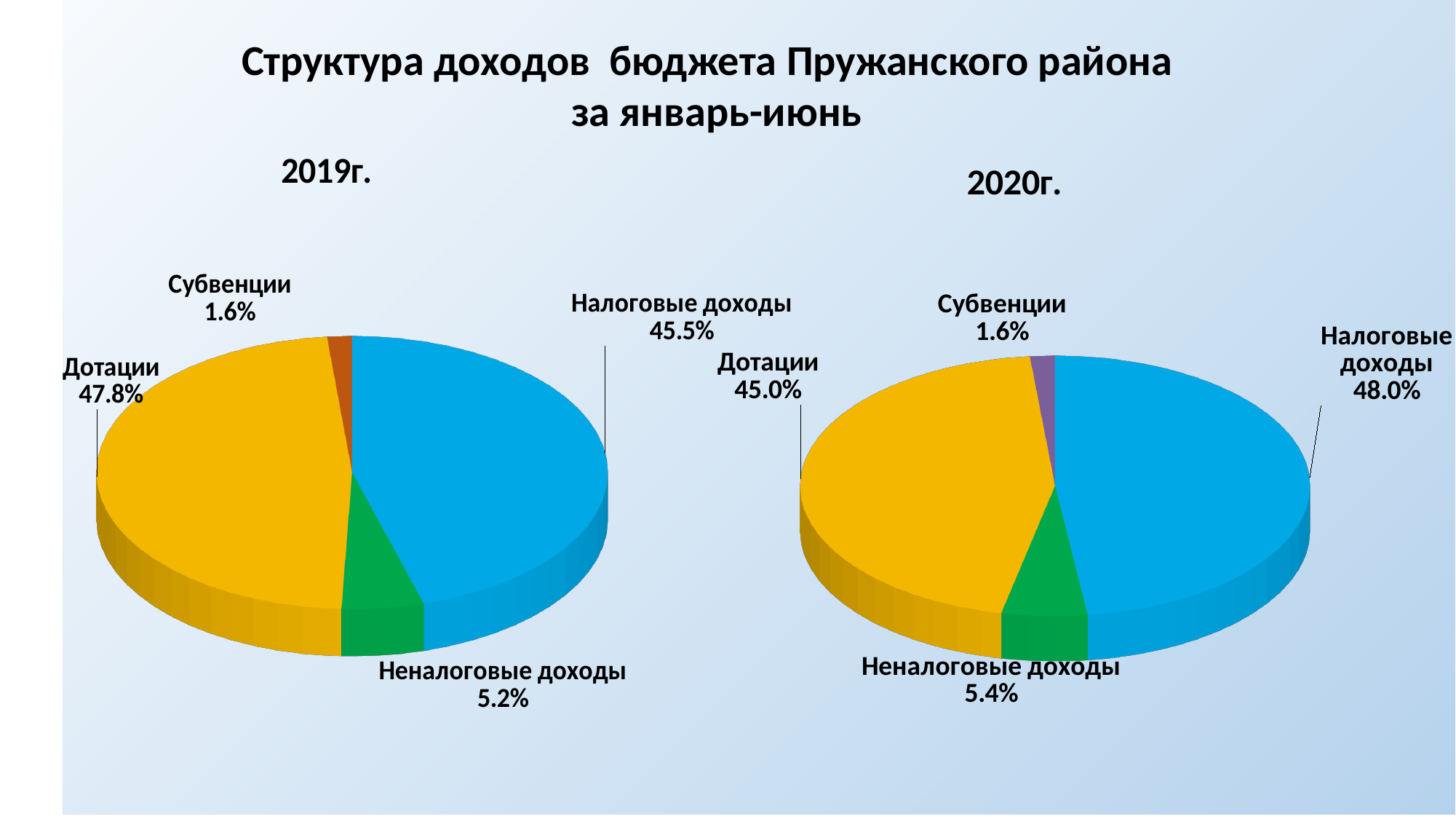
In the 2019г. chart, what is the difference between the shares of Дотации and Налоговые доходы? 2.3% How many categories does the 2019г. chart show? 4 In the 2020г. chart, which is larger: Налоговые доходы or Дотации? Налоговые доходы In the 2020г. chart, what is the difference between the shares of Налоговые доходы and Неналоговые доходы? 42.6% In the 2020г. chart, which category has the smallest share? Субвенции In the 2019г. chart, what share is Неналоговые доходы? 5.2% In the 2020г. chart, what share is Субвенции? 1.6% In the 2020г. chart, what share is Дотации? 45.0% In the 2020г. chart, which category has the largest share? Налоговые доходы In the 2019г. chart, which category has the largest share? Дотации What kind of chart is the 2020г. chart? Pie chart In the 2019г. chart, what share is Налоговые доходы? 45.5%